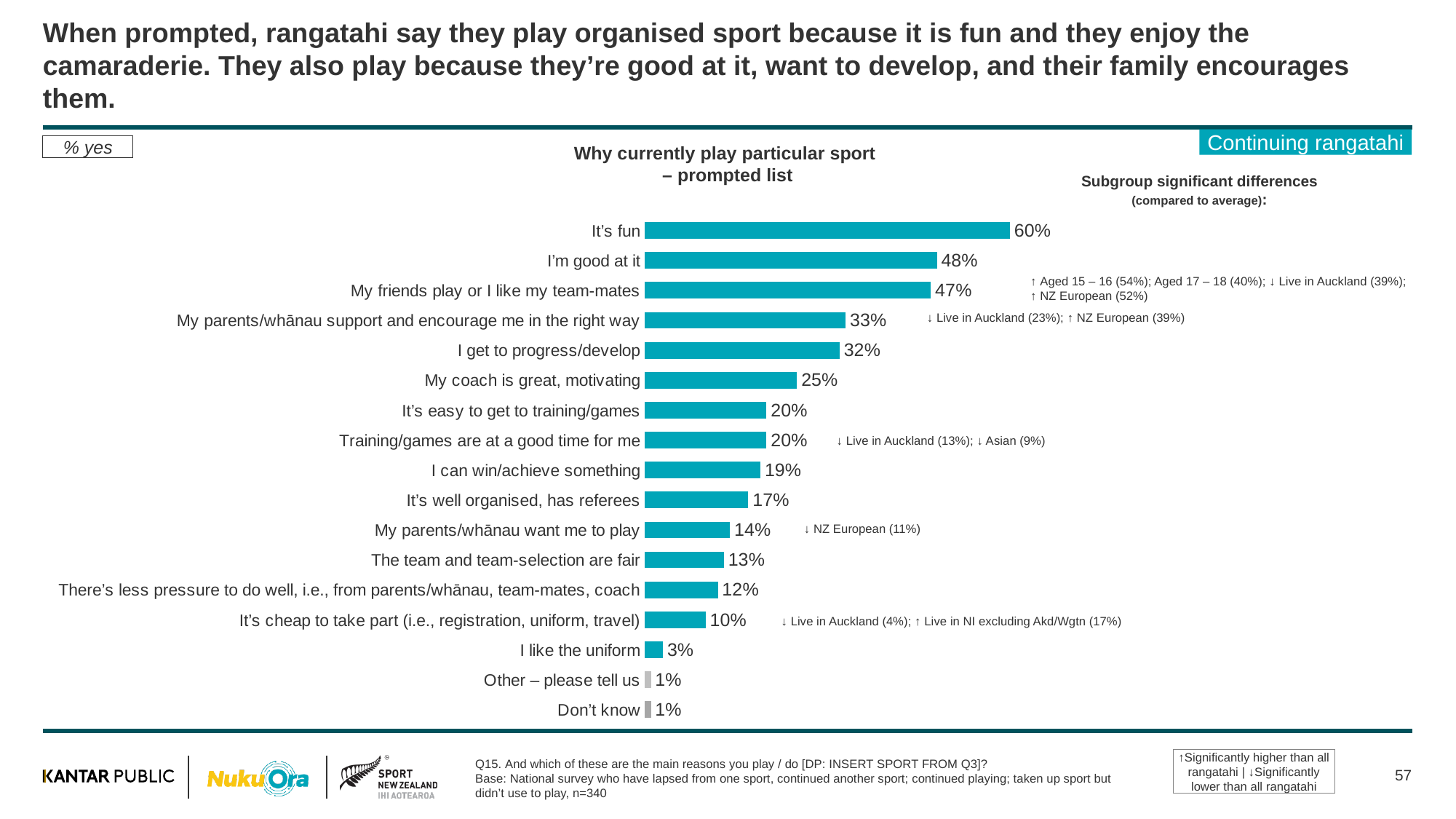
Which is larger: 'I can win/achieve something' or 'It's well organised, has referees'? I can win/achieve something What is the value for 'I like the uniform'? 3% What is the title of the chart? Why currently play particular sport – prompted list What kind of chart is shown on the slide? Bar chart What is the value for 'My coach is great, motivating'? 25% What percentage say 'It's cheap to take part (i.e., registration, uniform, travel)'? 10% What is the difference between 'I'm good at it' and 'My friends play or I like my team-mates'? 1% What percentage of rangatahi say they play their sport because it's fun? 60% Which reason has the highest percentage? It's fun How many reasons are listed in the chart? 17 Which is larger: 'My parents/whānau want me to play' or 'The team and team-selection are fair'? My parents/whānau want me to play What is the difference between 'It's fun' and 'I get to progress/develop'? 28%